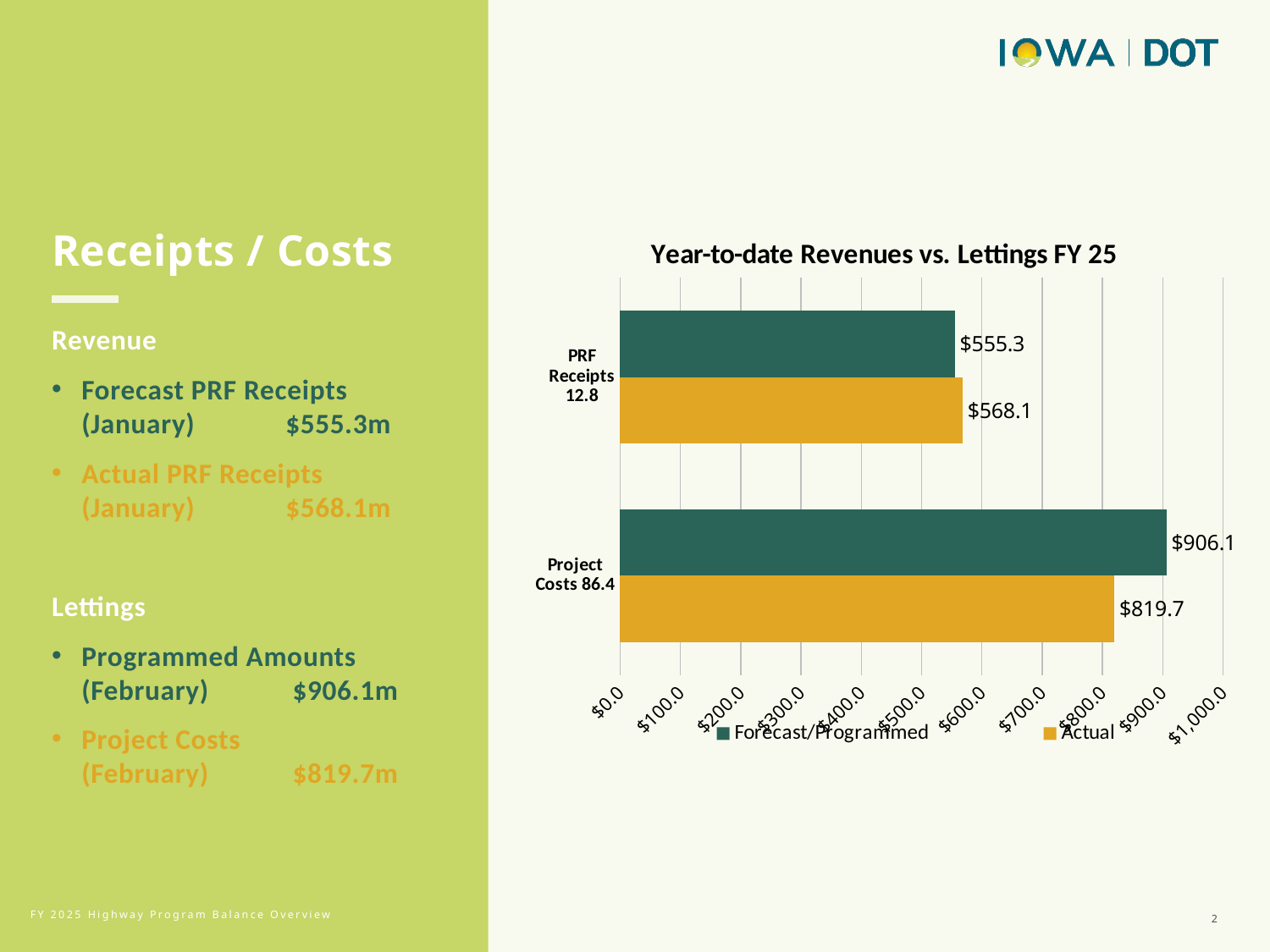
What is the Forecast/Programmed value for PRF Receipts in the chart? $555.3 What is the difference between the Actual and Forecast/Programmed values for PRF Receipts? $12.8 What type of chart is shown on the slide? Bar chart What is the difference between the Forecast/Programmed and Actual values for Project Costs? $86.4 Which bar in the chart has the highest value? Project Costs, Forecast/Programmed ($906.1) What is the title of the chart? Year-to-date Revenues vs. Lettings FY 25 How many series does the chart legend list? 2 What is the Forecast/Programmed value for Project Costs in the chart? $906.1 Which bar in the chart has the lowest value? PRF Receipts, Forecast/Programmed ($555.3) What is the Actual value for PRF Receipts in the chart? $568.1 For Project Costs, which is larger: the Forecast/Programmed value or the Actual value? Forecast/Programmed What is the Actual value for Project Costs in the chart? $819.7